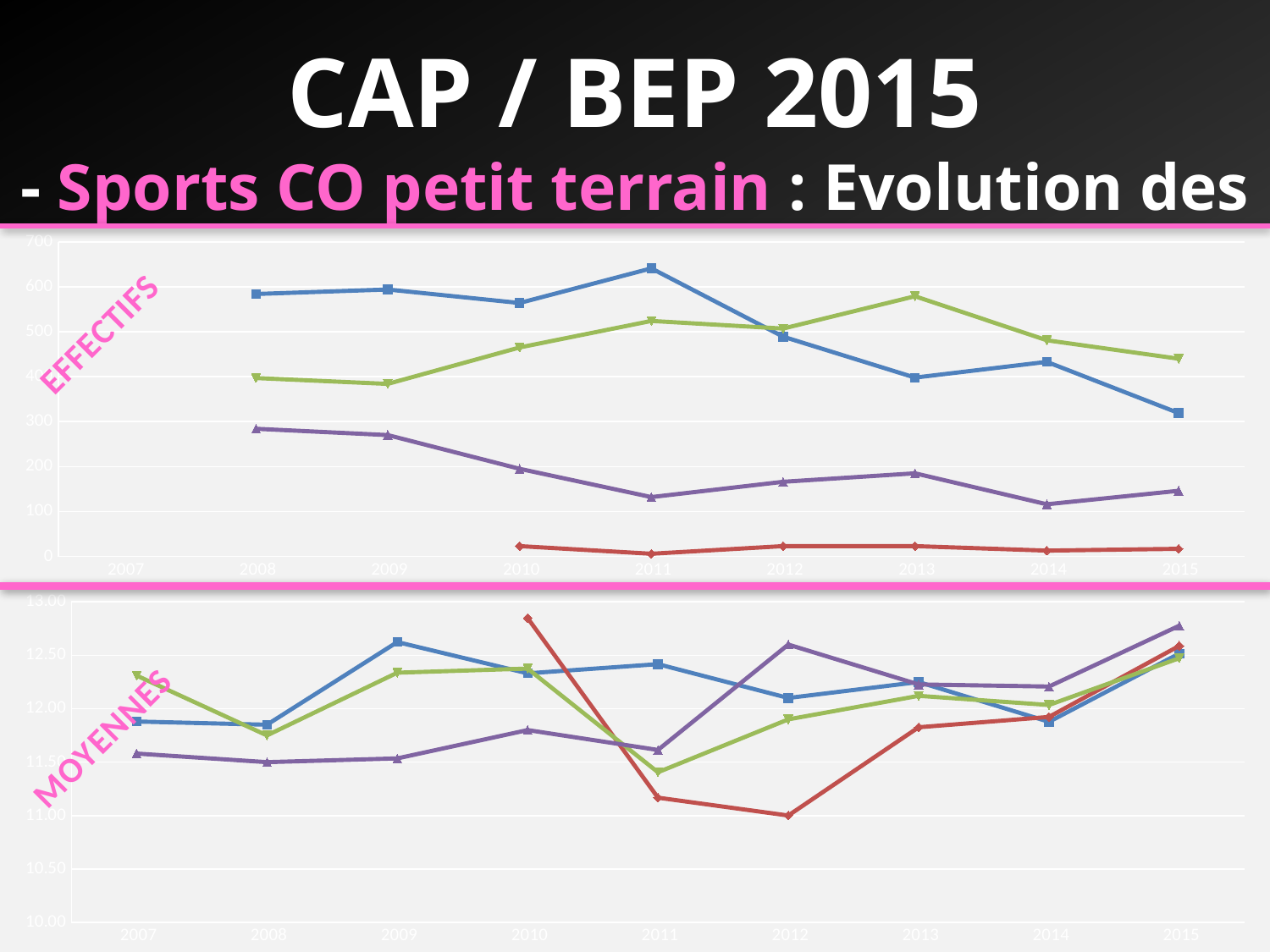
What kind of chart is the top chart labelled EFFECTIFS? line chart In the top chart (EFFECTIFS), in which year does the purple line reach its lowest value? 2014 How many years are shown on the x axis of the top chart (EFFECTIFS)? 9 In the top chart (EFFECTIFS), is the value of the blue line in 2011 greater or less than 600? greater In the bottom chart (MOYENNES), in which year does the red line reach its lowest value? 2012 In the top chart (EFFECTIFS), in which year does the blue line reach its highest value? 2011 What is the label written along the left side of the bottom chart? MOYENNES In the bottom chart (MOYENNES), is the value of the purple line in 2015 greater or less than 12.50? greater How many lines are plotted in the top chart (EFFECTIFS)? 4 In the top chart (EFFECTIFS), which line has the higher value in 2013, the blue line or the green line? green line In the top chart (EFFECTIFS), is the value of the blue line in 2015 greater or less than 400? less In the top chart (EFFECTIFS), does the purple line rise or fall from 2008 to 2011? fall